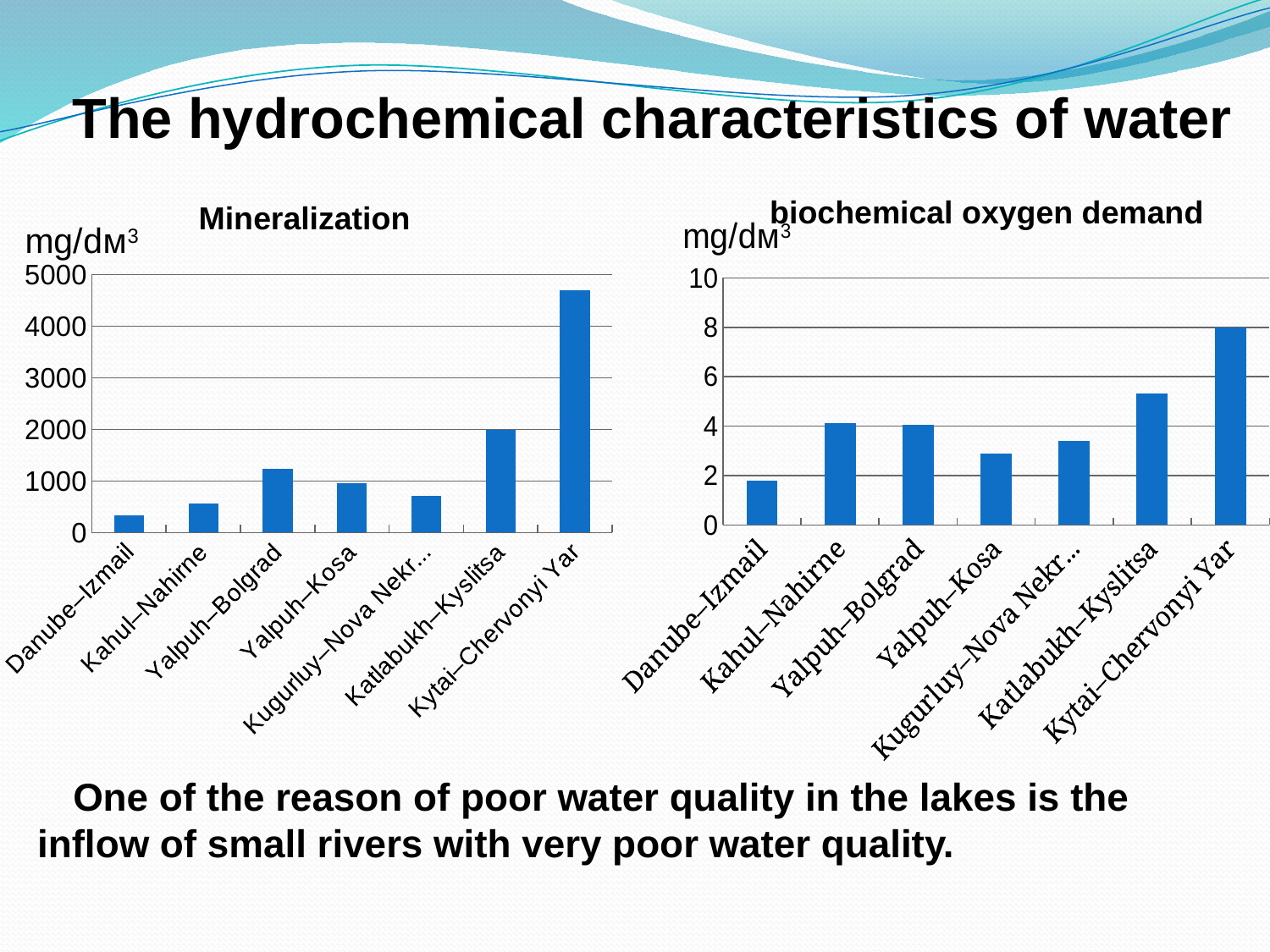
In the biochemical oxygen demand chart, is the value for Danube–Izmail greater or less than 2? less How many categories are shown in the Mineralization chart? 7 In the Mineralization chart, which is larger, the value for Yalpuh–Bolgrad or the value for Kugurluy–Nova Nekr...? Yalpuh–Bolgrad In the Mineralization chart, which category has the highest value? Kytai–Chervonyi Yar In the Mineralization chart, which category has the lowest value? Danube–Izmail What kind of chart is the biochemical oxygen demand chart? bar chart In the Mineralization chart, is the value for Kytai–Chervonyi Yar greater or less than 4000? greater In the biochemical oxygen demand chart, which is larger, the value for Katlabukh–Kyslitsa or the value for Yalpuh–Kosa? Katlabukh–Kyslitsa In the biochemical oxygen demand chart, which category has the highest value? Kytai–Chervonyi Yar In the biochemical oxygen demand chart, is the value for Katlabukh–Kyslitsa greater or less than 6? less In the biochemical oxygen demand chart, which category has the lowest value? Danube–Izmail